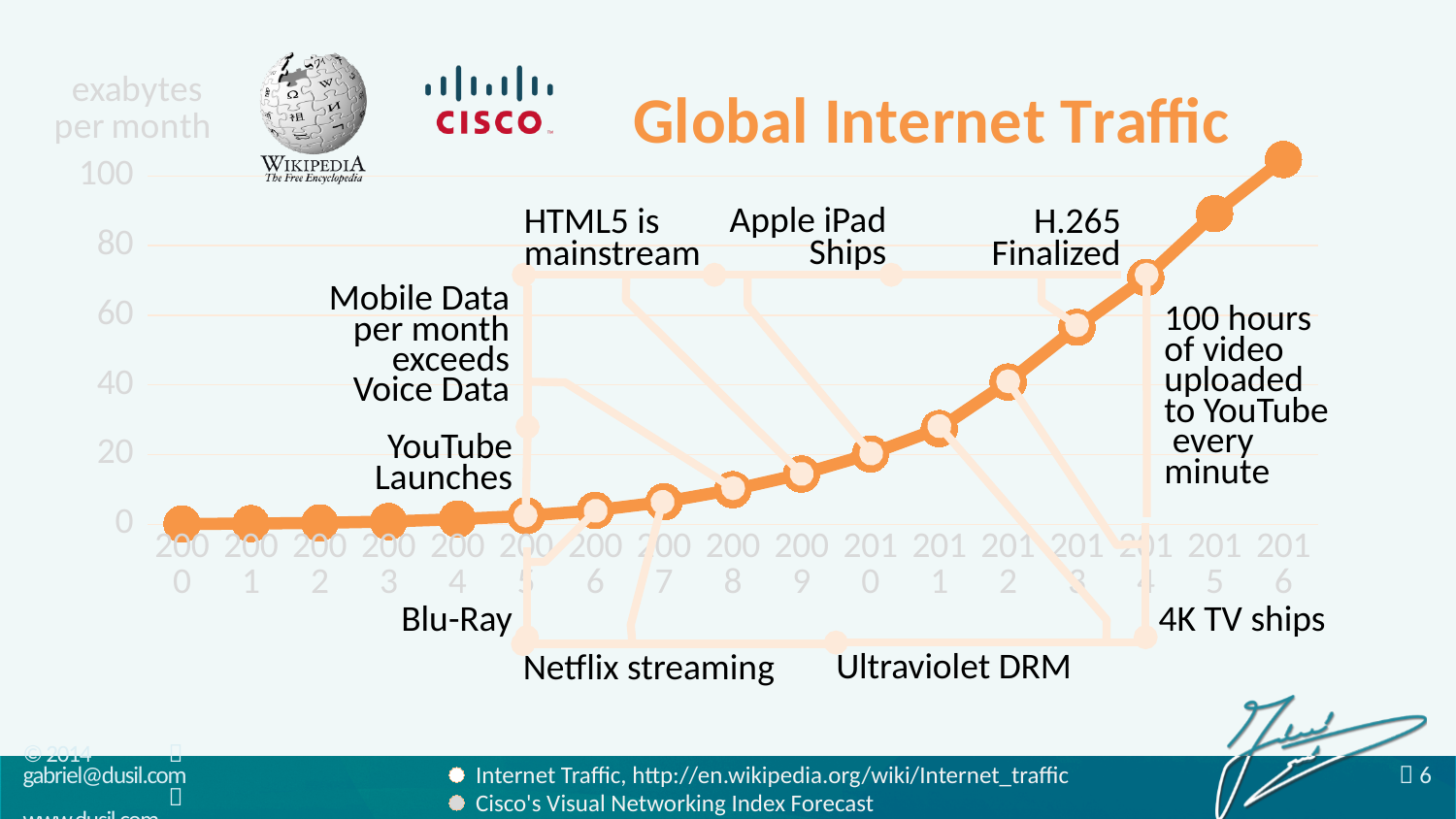
What is the title of the chart? Global Internet Traffic Is the value for 2015 greater or less than 60? greater What unit is shown on the y axis of the chart? exabytes per month Is the value for 2011 greater or less than 40? less Do the values rise or fall from 2000 to 2016? rise Is the value for 2013 greater or less than 40? greater Which year has the highest value on the chart? 2016 How many data points are plotted on the line? 17 What kind of chart is shown on the slide? line chart Which is larger, the value for 2015 or the value for 2012? 2015